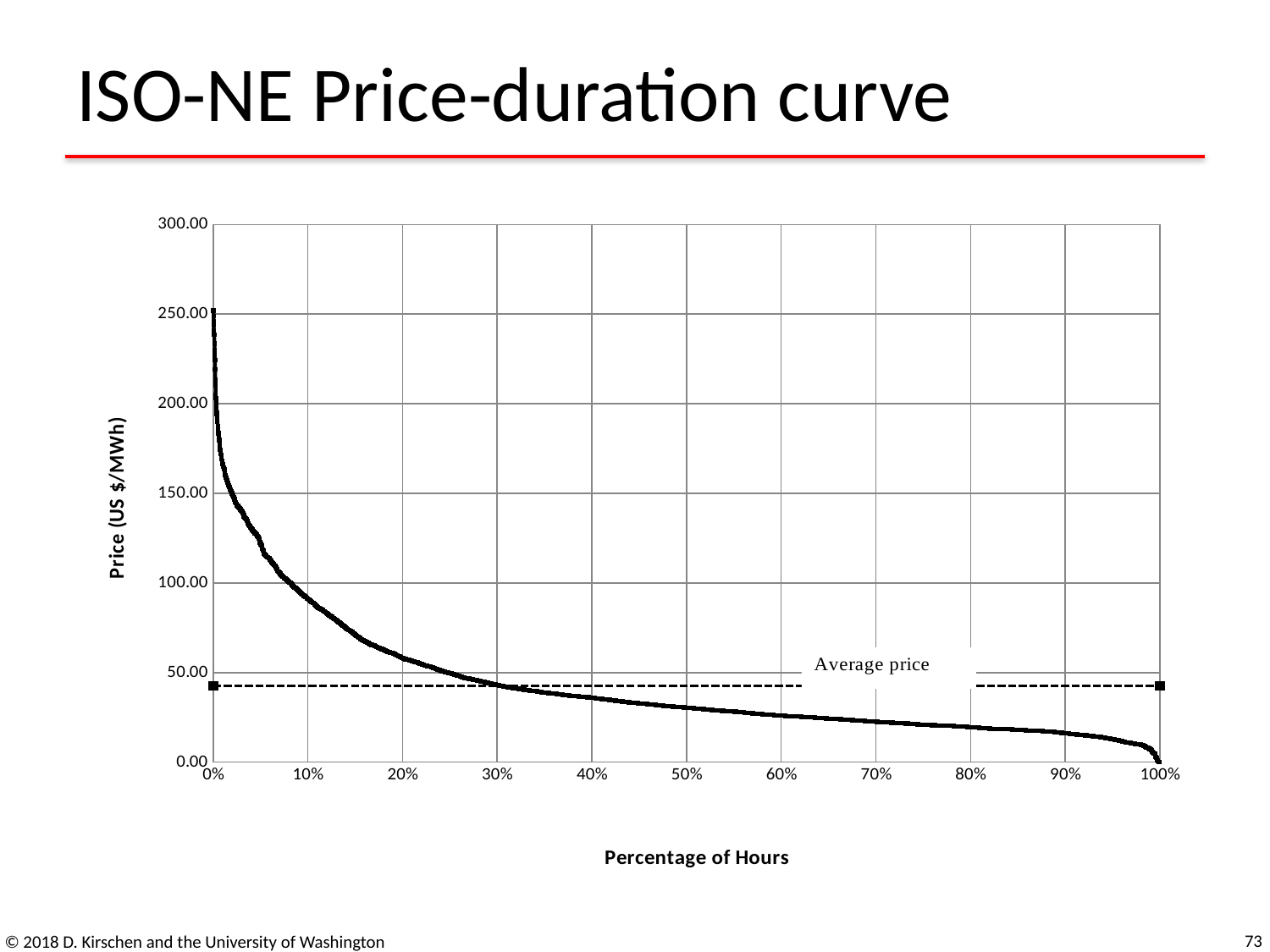
What kind of chart is shown on the slide? line chart What is the label of the vertical axis? Price (US $/MWh) At which percentage of hours is the price highest? 0% Which is larger, the price at 10% of hours or the price at 60% of hours? the price at 10% of hours Is the price at 90% of hours greater or less than 50? less Is the price at 0% of hours greater or less than 200? greater What is the title of the chart? ISO-NE Price-duration curve Is the average price shown by the dashed line greater or less than 50? less Do prices rise or fall as the percentage of hours increases along the x axis? fall At which percentage of hours is the price lowest? 100%